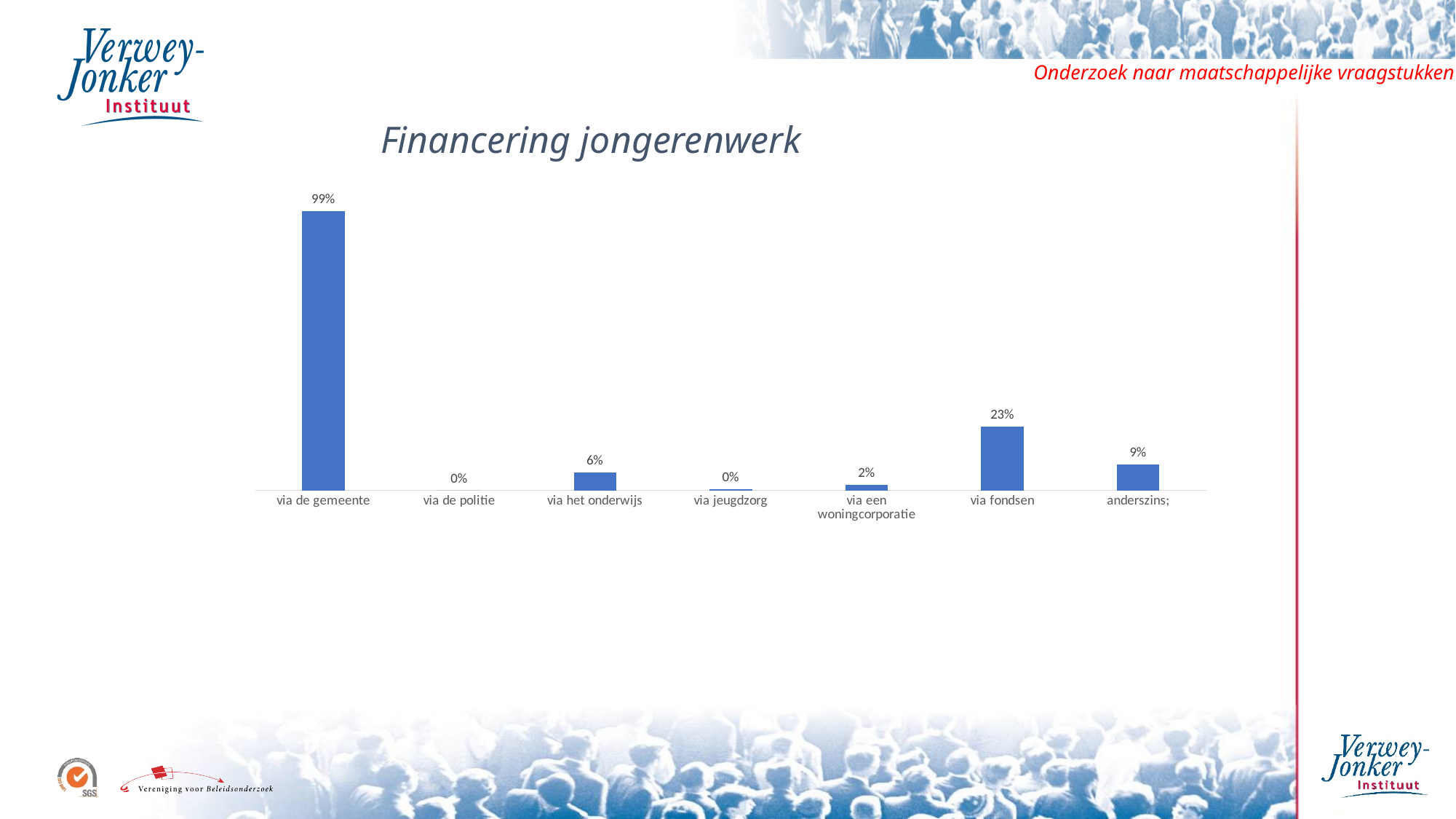
What is the value for 'via fondsen'? 23% What is the value for 'via het onderwijs'? 6% How many categories are shown on the x axis? 7 What kind of chart is shown on the slide? bar chart What is the title of the slide containing the chart? Financering jongerenwerk Which category has the highest value? via de gemeente Which is larger, the value for 'via het onderwijs' or the value for 'anderszins;'? anderszins; What is the value for 'anderszins;'? 9% What is the difference between the values for 'via fondsen' and 'anderszins;'? 14% What is the difference between the values for 'via de gemeente' and 'via fondsen'? 76% What is the value for 'via de gemeente'? 99% What is the value for 'via een woningcorporatie'? 2%